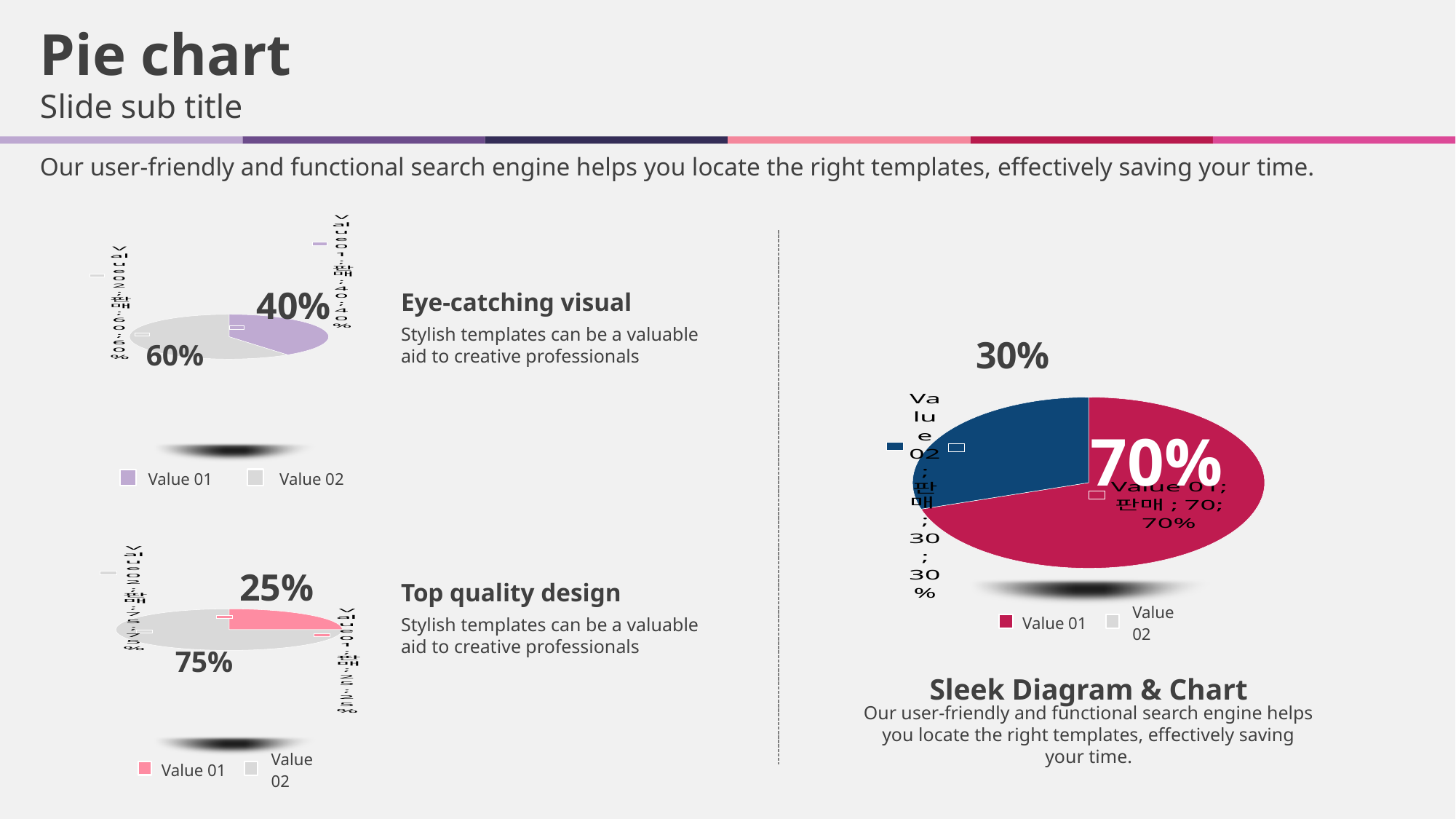
In the bottom-left pie chart, which category has the smaller share? Value 01 In the top-left pie chart, what is the value for Value 02? 60% In the top-left pie chart, which category has the larger share? Value 02 In the pie chart on the right, is Value 01 or Value 02 larger? Value 01 In the bottom-left pie chart, what is the value for Value 02? 75% In the bottom-left pie chart, what is the value for Value 01? 25% In the pie chart on the right, what is the value for Value 02? 30% How many entries does the legend of the pie chart on the right list? 2 In the top-left pie chart, what is the difference between Value 02 and Value 01? 20% In the pie chart on the right, what is the value for Value 01? 70% In the top-left pie chart, what is the value for Value 01? 40% In the bottom-left pie chart, what is the difference between Value 02 and Value 01? 50%